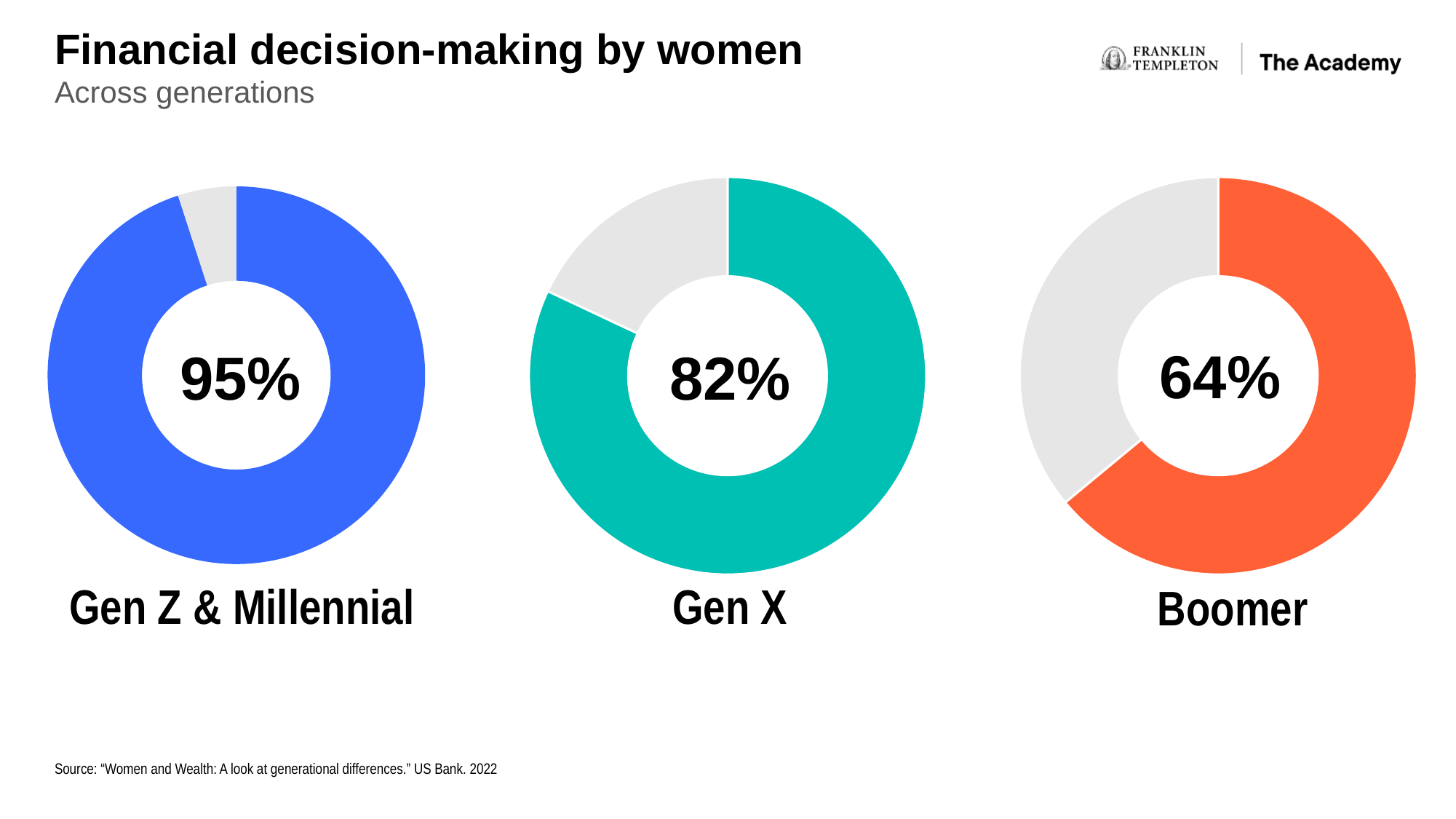
Which is larger, the Gen X percentage or the Boomer percentage? Gen X Which generation has the lowest percentage across the three donut charts? Boomer How many donut charts are shown on the slide? 3 What percentage is shown in the Gen Z & Millennial donut chart? 95% What is the difference between the Gen X percentage and the Boomer percentage? 18% What kind of chart is used to show each generation's percentage? Donut chart What colour is the filled portion of the Boomer donut chart? Orange What percentage is shown in the Boomer donut chart? 64% Which generation has the highest percentage across the three donut charts? Gen Z & Millennial What is the difference between the Gen Z & Millennial percentage and the Boomer percentage? 31% What percentage is shown in the Gen X donut chart? 82% Do the percentages rise or fall moving from the Gen Z & Millennial chart on the left to the Boomer chart on the right? Fall